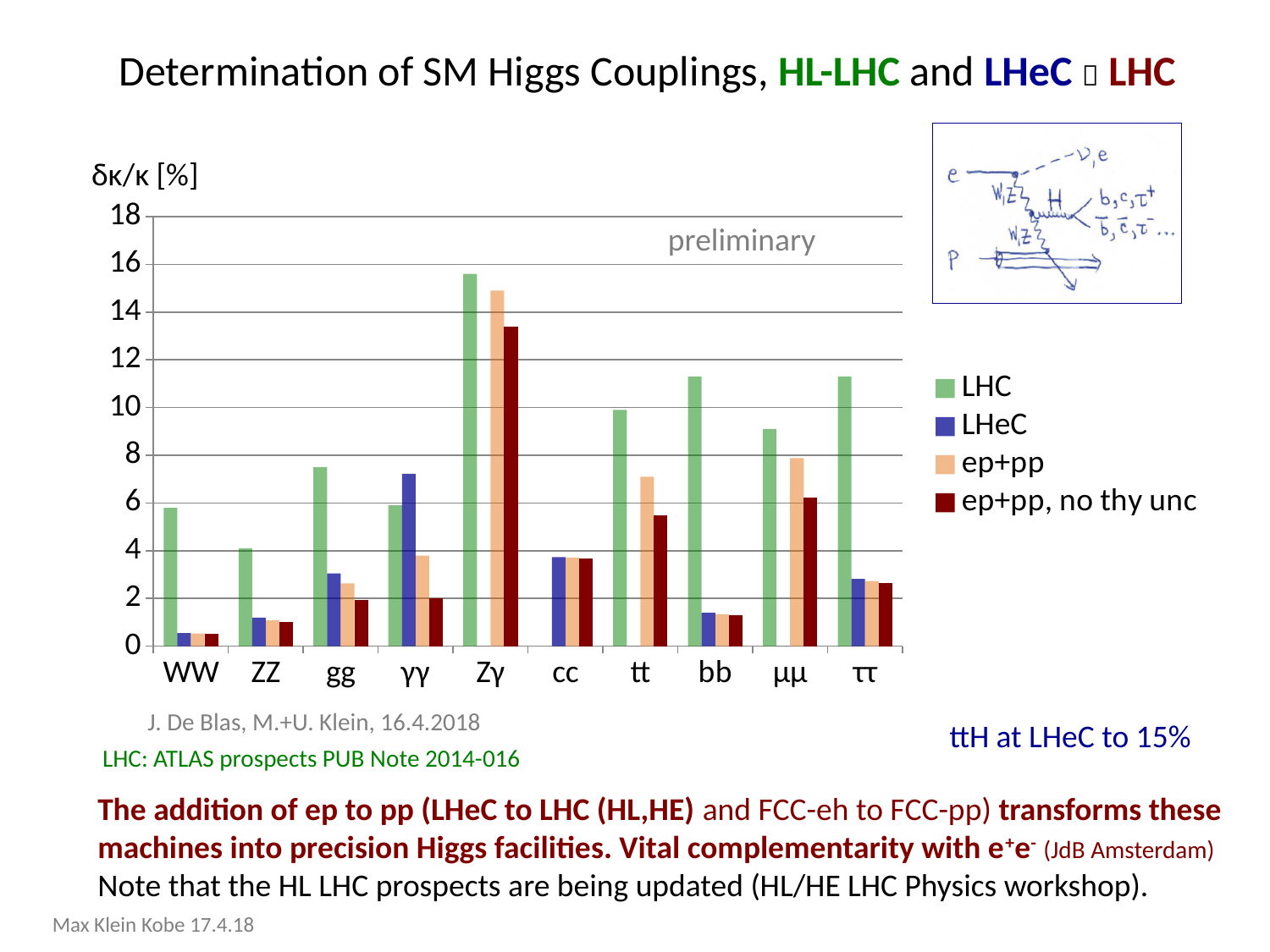
What kind of chart is shown on the slide? bar chart Which is larger for the LHC series: the value for gg or the value for WW? gg For the LHC series, which category has the highest value? Zγ What is the label on the y axis of the chart? δκ/κ [%] For the γγ category, which is larger: the LHeC value or the ep+pp value? LHeC Is the LHC value for bb greater or less than 10? greater How many coupling categories are shown along the x axis? 10 For the LHeC series, which category has the highest value? γγ How many series does the chart legend list? 4 Is the ep+pp value for tt greater or less than 6? greater Is the LHeC value for gg greater or less than 4? less